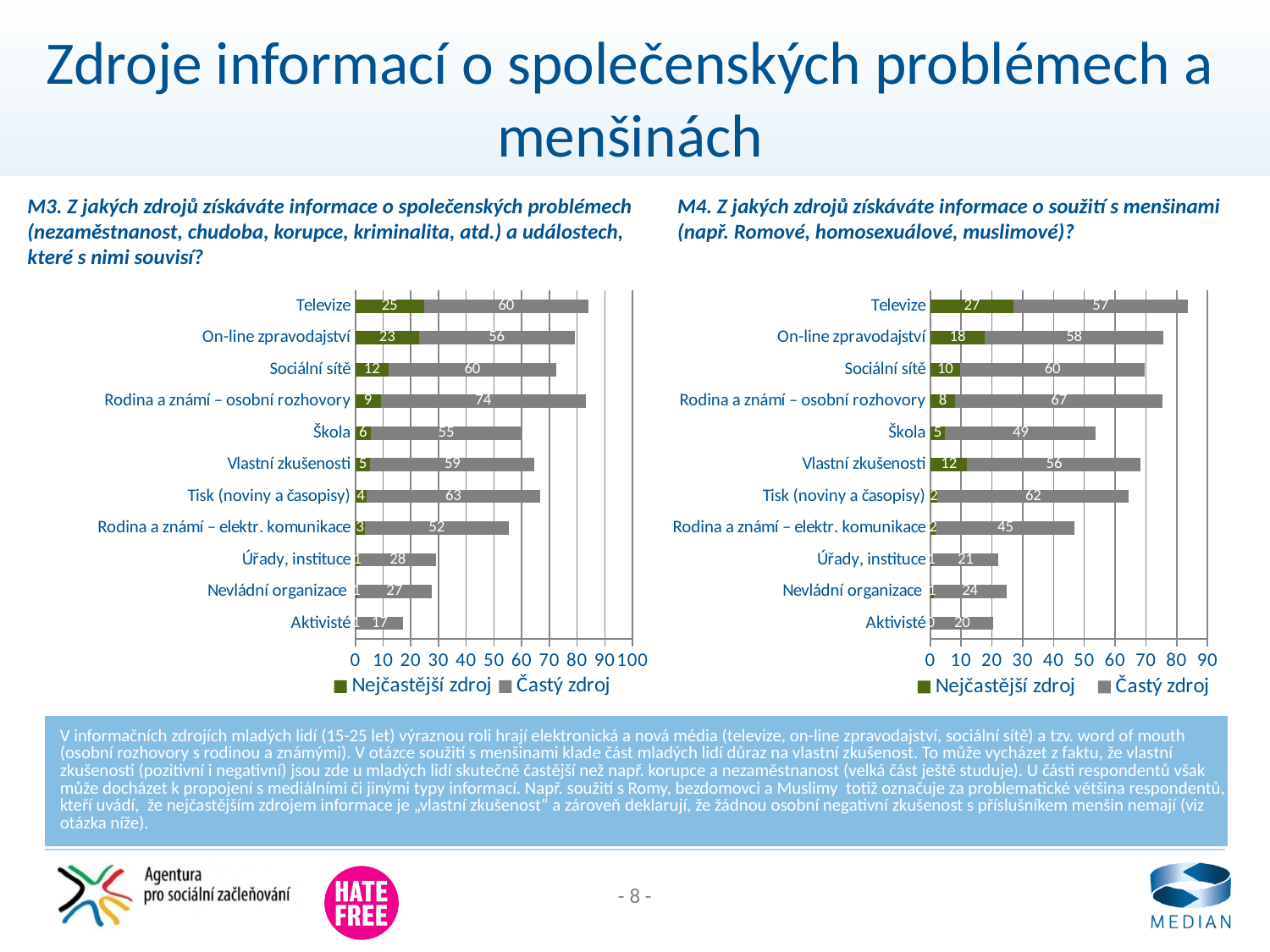
How many series does the legend of the right chart (M4) list? 2 In the right chart (M4), what is the 'Nejčastější zdroj' value for Vlastní zkušenosti? 12 In the left chart (M3), what is the 'Častý zdroj' value for Rodina a známí – osobní rozhovory? 74 How many categories does the left chart (M3) show? 11 In the right chart (M4), what is the 'Častý zdroj' value for Tisk (noviny a časopisy)? 62 In the right chart (M4), what is the difference between the 'Častý zdroj' values for Sociální sítě and Škola? 11 In the right chart (M4), which has a larger 'Nejčastější zdroj' value: Televize or On-line zpravodajství? Televize In the left chart (M3), what is the 'Nejčastější zdroj' value for Televize? 25 What type of chart is the left chart (M3)? Stacked bar chart In the left chart (M3), what is the total of the stacked bar for Televize? 85 In the right chart (M4), which category has the lowest 'Častý zdroj' value? Aktivisté In the left chart (M3), which category has the highest 'Nejčastější zdroj' value? Televize